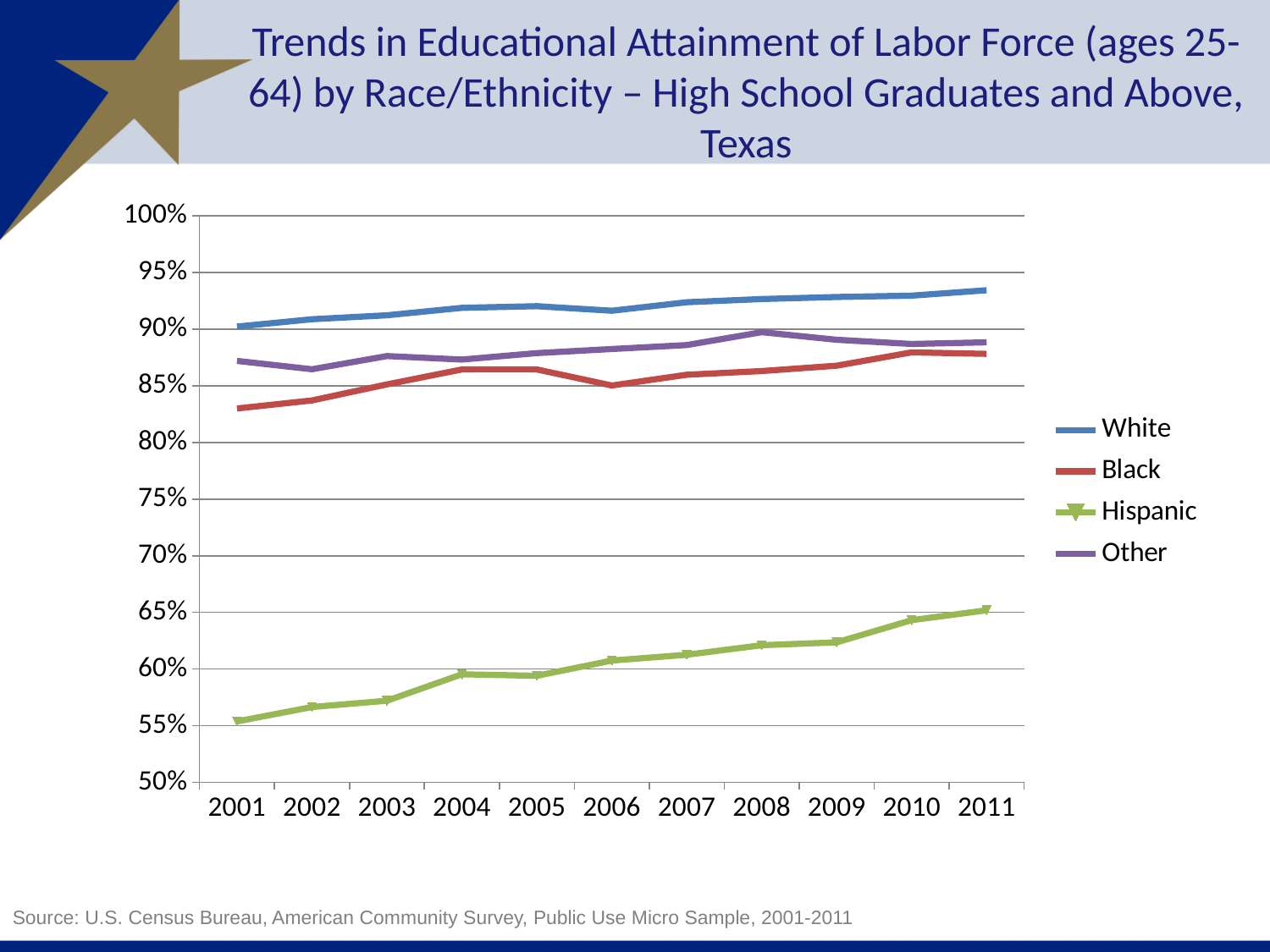
How many series does the legend list? 4 Which race/ethnicity group has the lowest value in 2001? Hispanic How many years are shown along the x axis? 11 Does the Hispanic line rise or fall from 2001 to 2011? rise Is the value for Other in 2008 greater or less than 85%? greater In 2001, which is larger: the value for Other or the value for Black? Other Which race/ethnicity group has the highest value in 2011? White Is the value for Hispanic in 2001 greater or less than 60%? less What kind of chart is shown on the slide? line chart Is the value for Black in 2001 greater or less than 85%? less What colour is the Hispanic line in the legend? green